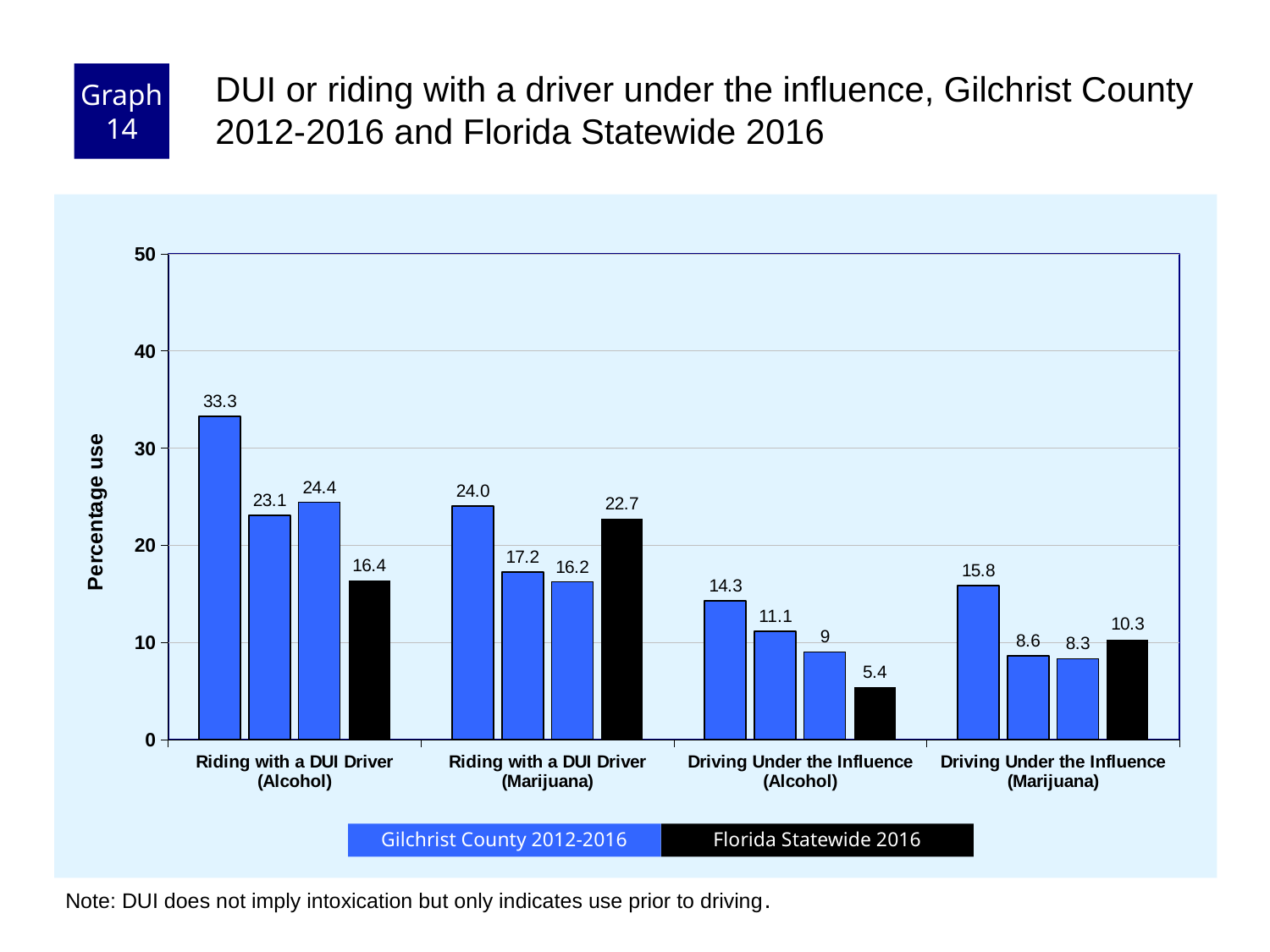
How many series does the legend list? 2 What is the Florida Statewide 2016 value for Driving Under the Influence (Marijuana)? 10.3 What is the Florida Statewide 2016 value for Riding with a DUI Driver (Alcohol)? 16.4 For which category is the Florida Statewide 2016 bar the tallest? Riding with a DUI Driver (Marijuana) How many categories are shown on the x axis? 4 What is the highest value shown on the chart? 33.3 What is the difference between the Florida Statewide 2016 values for Riding with a DUI Driver (Marijuana) and Riding with a DUI Driver (Alcohol)? 6.3 What is the lowest value shown on the chart? 5.4 Which is larger: the Florida Statewide 2016 value for Driving Under the Influence (Marijuana) or for Driving Under the Influence (Alcohol)? Driving Under the Influence (Marijuana) What is the Florida Statewide 2016 value for Driving Under the Influence (Alcohol)? 5.4 Is the Florida Statewide 2016 value for Riding with a DUI Driver (Marijuana) greater or less than 20? greater What kind of chart is shown on the slide? bar chart